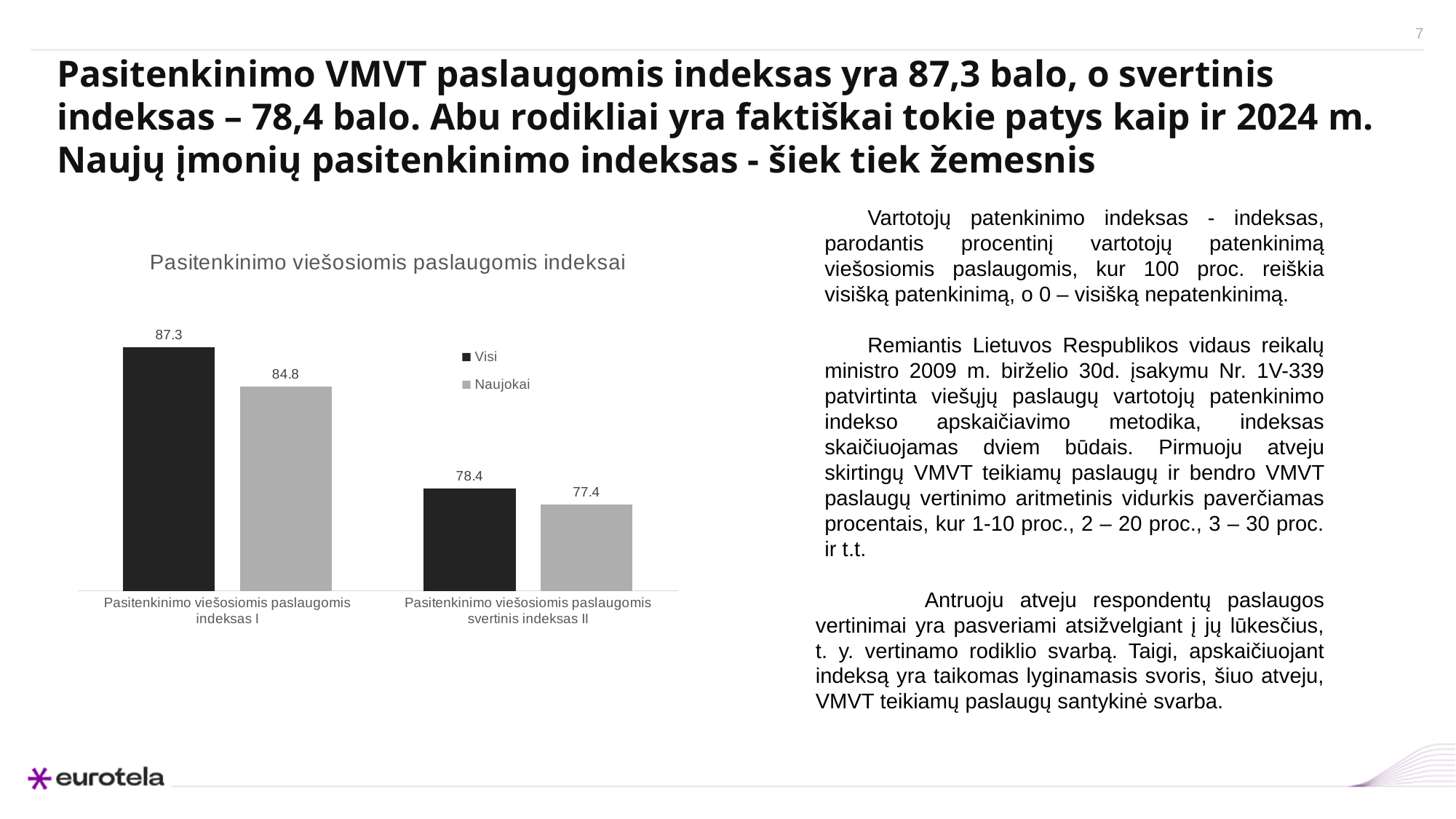
How many series does the chart legend list? 2 What type of chart is shown on the slide? Bar chart What is the value for Visi in the category 'Pasitenkinimo viešosiomis paslaugomis indeksas I'? 87.3 What is the value for Naujokai in the category 'Pasitenkinimo viešosiomis paslaugomis indeksas I'? 84.8 What is the difference between the Visi and Naujokai values for 'Pasitenkinimo viešosiomis paslaugomis indeksas I'? 2.5 What is the difference between the Visi values for indeksas I and svertinis indeksas II? 8.9 What is the value for Naujokai in the category 'Pasitenkinimo viešosiomis paslaugomis svertinis indeksas II'? 77.4 Which is larger: the Visi value for svertinis indeksas II or the Naujokai value for indeksas I? Naujokai value for indeksas I What is the value for Visi in the category 'Pasitenkinimo viešosiomis paslaugomis svertinis indeksas II'? 78.4 Which bar has the lowest value in the chart? Naujokai, Pasitenkinimo viešosiomis paslaugomis svertinis indeksas II Which bar has the highest value in the chart? Visi, Pasitenkinimo viešosiomis paslaugomis indeksas I How many categories are shown on the x axis of the chart? 2